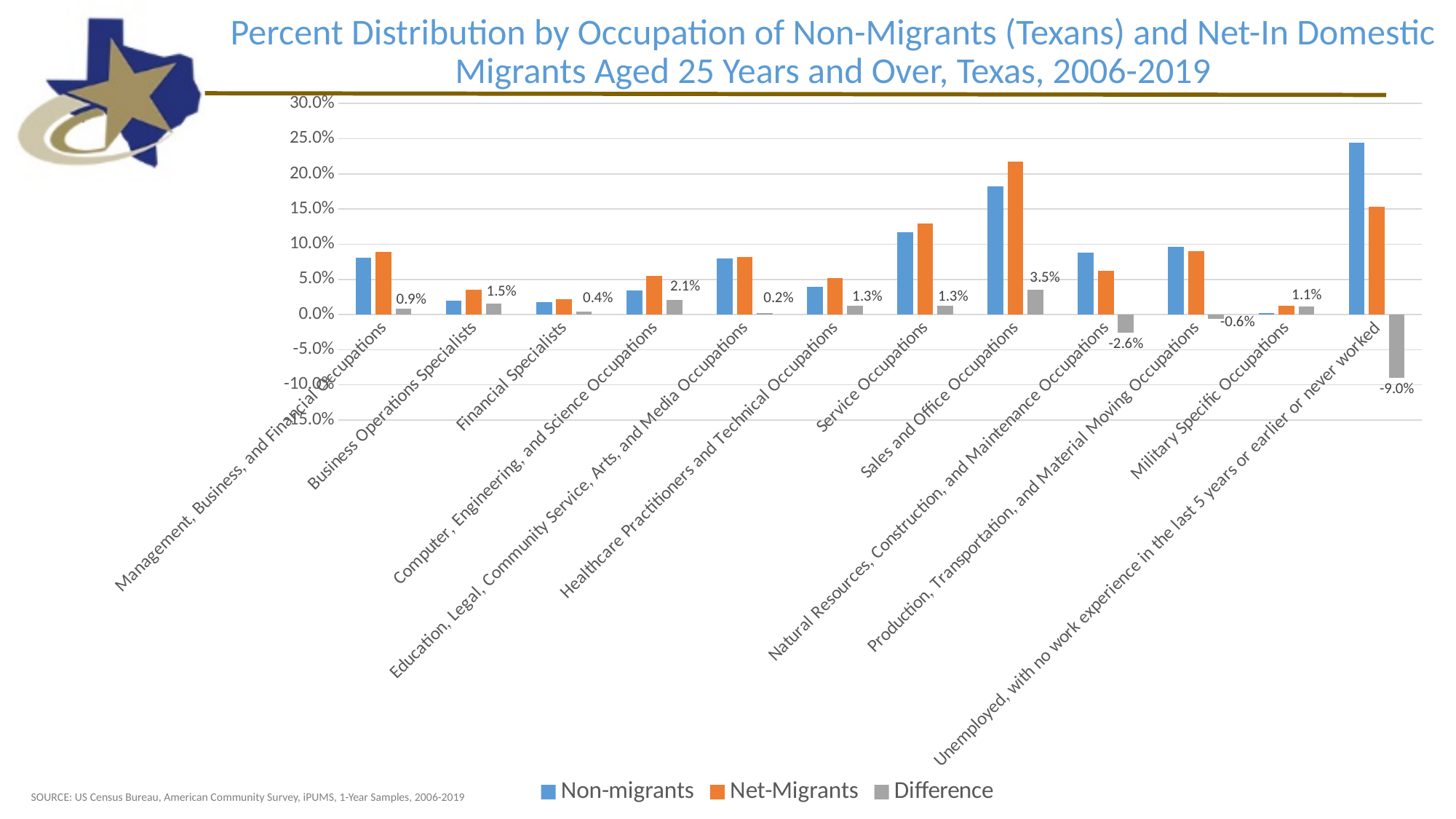
Which category has the lowest Difference value? Unemployed, with no work experience in the last 5 years or earlier or never worked Is the Non-migrants value for Unemployed, with no work experience in the last 5 years or earlier or never worked greater or less than 20.0%? greater Which category has the highest Difference value? Sales and Office Occupations How many series does the legend list? 3 What is the Difference value for Sales and Office Occupations? 3.5% Which series is shown in orange in the legend? Net-Migrants What type of chart is shown on the slide? Bar chart How many occupation categories are shown on the x axis? 12 What is the Difference value for Computer, Engineering, and Science Occupations? 2.1% What is the difference between the Difference values for Business Operations Specialists and Financial Specialists? 1.1% What is the Difference value for Unemployed, with no work experience in the last 5 years or earlier or never worked? -9.0% Which is larger for Natural Resources, Construction, and Maintenance Occupations: the Non-migrants value or the Net-Migrants value? Non-migrants